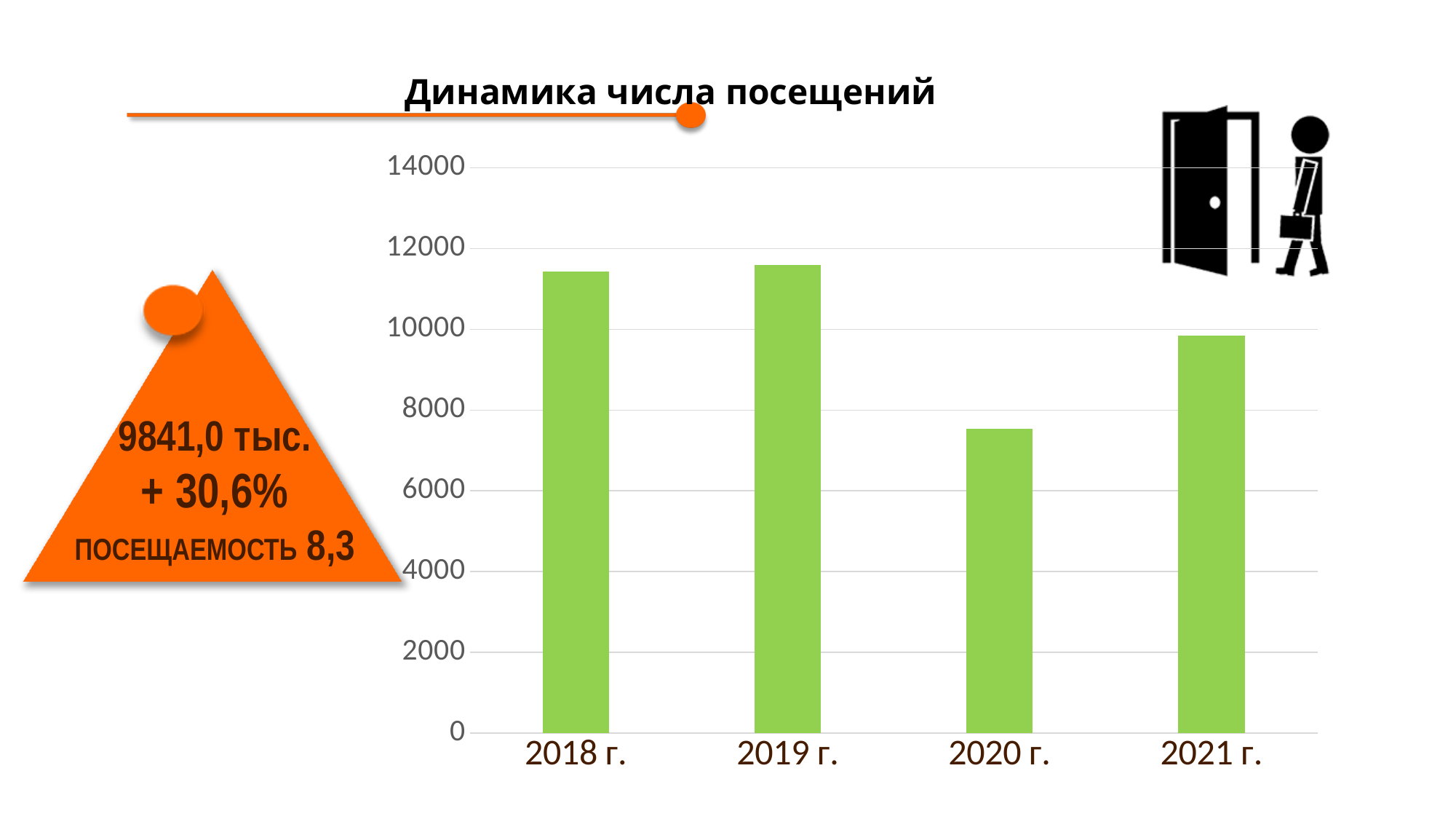
Is the value for 2019 г. greater or less than 12000? less Is the value for 2020 г. greater or less than 8000? less Is the value for 2018 г. greater or less than 10000? greater What is the title of the chart? Динамика числа посещений What type of chart is shown on the slide? bar chart Which is larger, the value for 2020 г. or the value for 2021 г.? 2021 г. Which year has the lowest value in the chart? 2020 г. Does the value rise or fall from 2019 г. to 2020 г.? fall How many categories (years) are shown on the x axis of the chart? 4 What colour are the bars in the chart? green